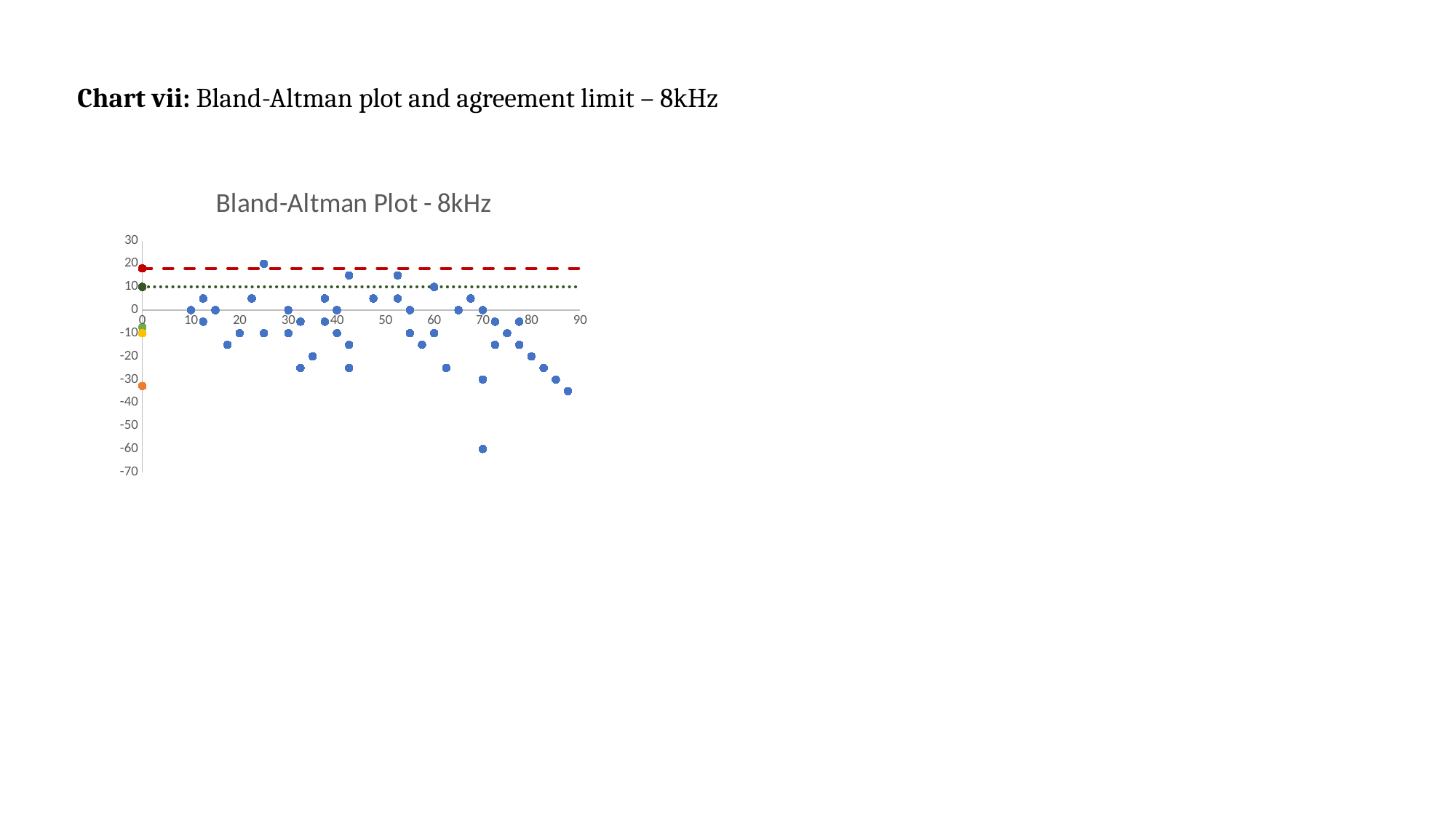
What colour is the dashed horizontal line on the chart? Red Is the lowest plotted point located at an x value greater or less than 50? greater Is the level of the green dotted line greater or less than 20? less Is the lowest plotted point on the chart greater or less than -50? less Which is higher on the chart, the red dashed line or the green dotted line? The red dashed line What is the title of the chart? Bland-Altman Plot - 8kHz What kind of chart is shown on the slide? Scatter plot